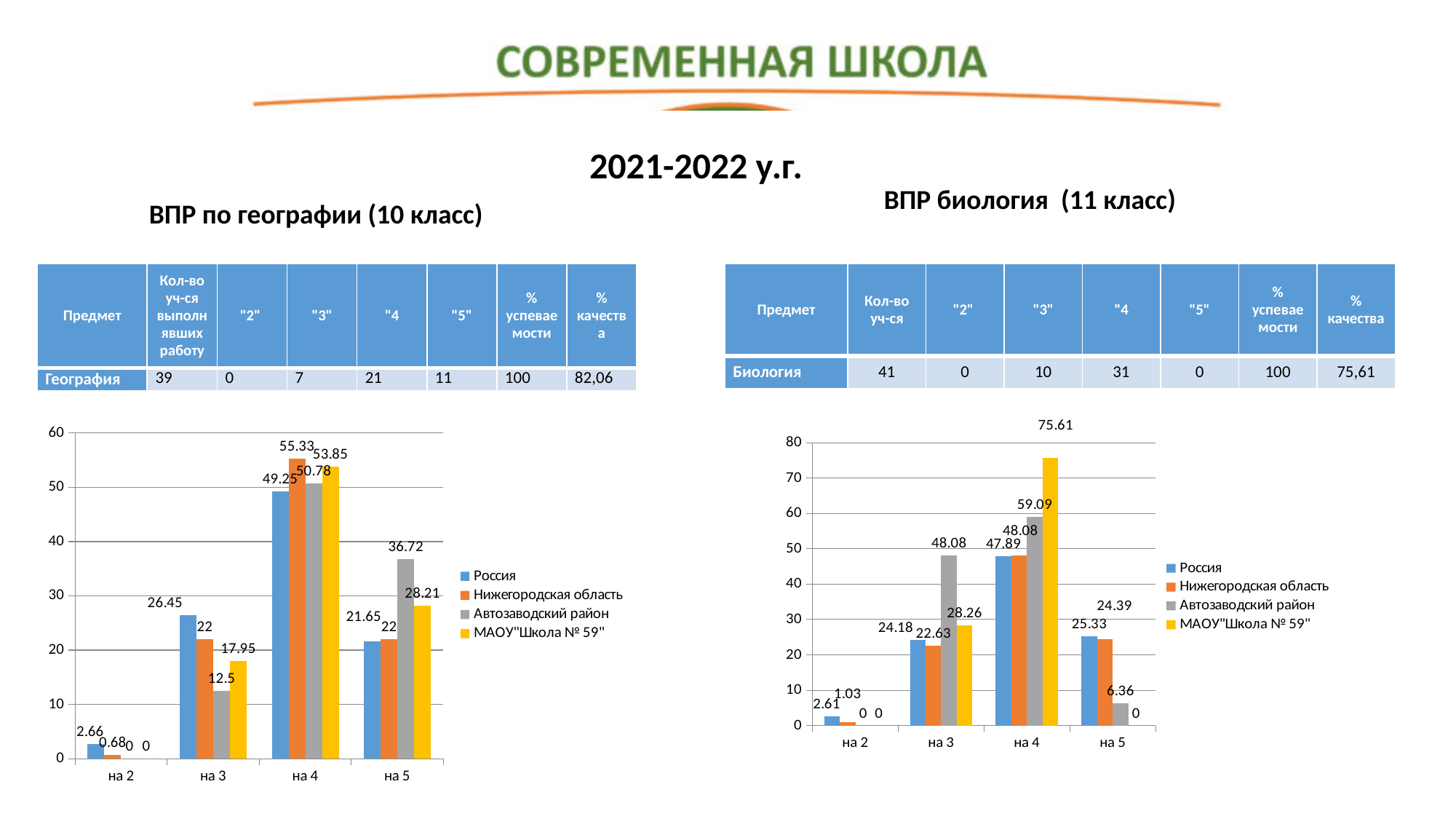
In the left chart (ВПР по географии, 10 класс), what is the difference between Россия and Автозаводский район at "на 3"? 13.95 In the right chart (ВПР биология, 11 класс), what is the value for Автозаводский район at "на 3"? 48.08 What type of chart is the left chart (ВПР по географии, 10 класс)? Bar chart In the left chart (ВПР по географии, 10 класс), what is the value for Автозаводский район at "на 5"? 36.72 In the right chart (ВПР биология, 11 класс), which series has the lowest value at "на 5"? МАОУ"Школа № 59" In the left chart (ВПР по географии, 10 класс), what is the value for МАОУ"Школа № 59" at "на 4"? 53.85 In the left chart (ВПР по географии, 10 класс), how many series does the legend list? 4 In the right chart (ВПР биология, 11 класс), how many categories are shown on the x axis? 4 In the right chart (ВПР биология, 11 класс), which is larger at "на 3": Россия or Нижегородская область? Россия In the right chart (ВПР биология, 11 класс), what is the difference between МАОУ"Школа № 59" and Автозаводский район at "на 4"? 16.52 In the left chart (ВПР по географии, 10 класс), which series has the highest value at "на 4"? Нижегородская область In the right chart (ВПР биология, 11 класс), what is the value for МАОУ"Школа № 59" at "на 4"? 75.61